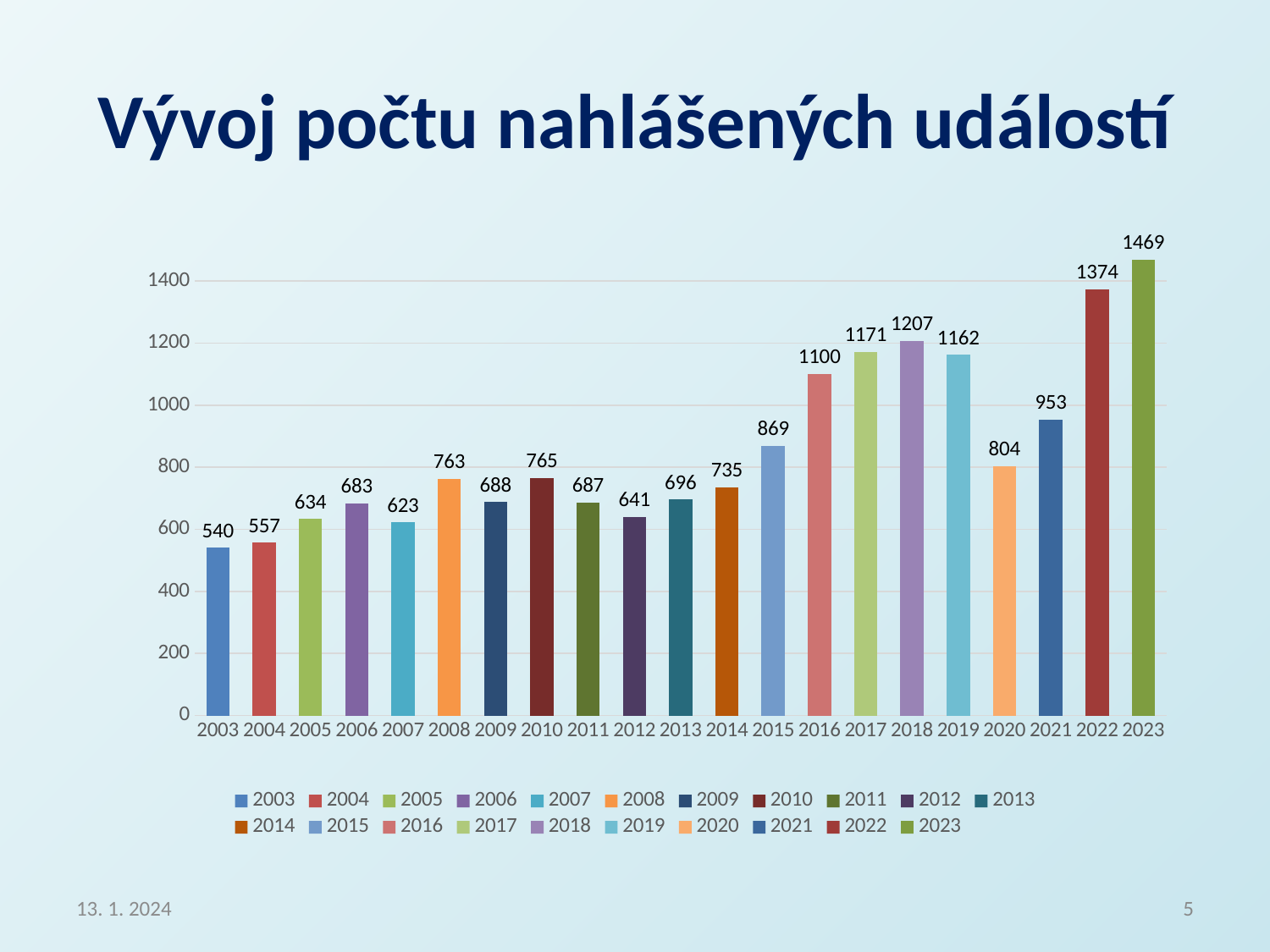
Which year has the highest value? 2023 What is the title of the slide? Vývoj počtu nahlášených událostí Which year has the lowest value? 2003 What is the value for 2020? 804 Is the value for 2021 greater or less than 1000? less What kind of chart is shown on the slide? bar chart How many years are shown on the x axis? 21 What is the difference between the values for 2016 and 2015? 231 Which is larger, the value for 2008 or the value for 2010? 2010 What is the value for 2018? 1207 What is the difference between the values for 2023 and 2022? 95 What is the value for 2003? 540